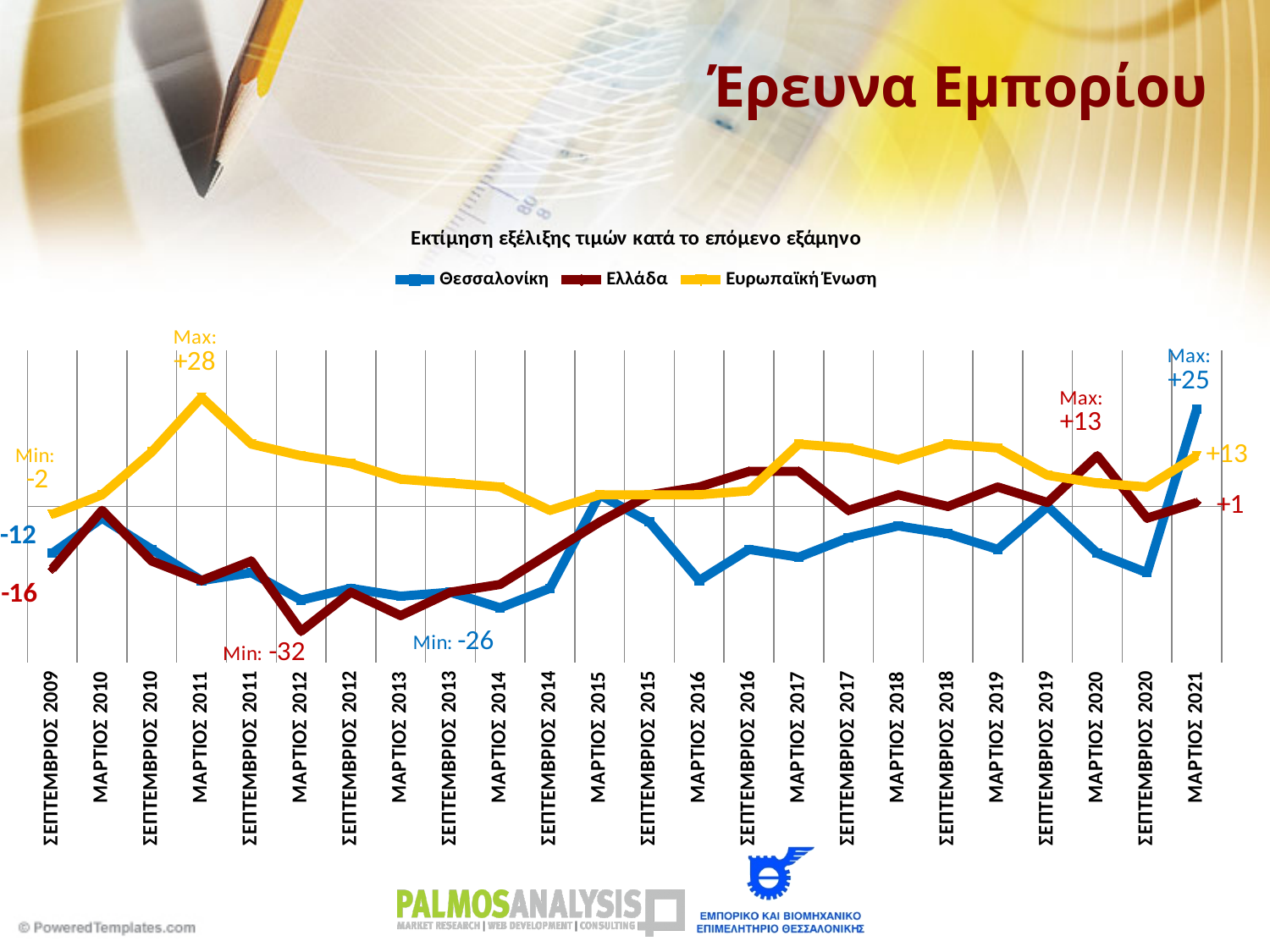
What is the maximum value labelled for the Ευρωπαϊκή Ένωση series? +28 What is the value for Θεσσαλονίκη in ΜΑΡΤΙΟΣ 2021? +25 What is the difference between the Θεσσαλονίκη and Ευρωπαϊκή Ένωση values in ΜΑΡΤΙΟΣ 2021? 12 In ΜΑΡΤΙΟΣ 2021, which series has the higher value, Θεσσαλονίκη or Ελλάδα? Θεσσαλονίκη What is the minimum value labelled for the Θεσσαλονίκη series? -26 What is the minimum value labelled for the Ελλάδα series? -32 What is the value for Ελλάδα in ΣΕΠΤΕΜΒΡΙΟΣ 2009? -16 How many time points are shown on the x axis? 24 What type of chart is shown on the slide? line chart How many series does the legend list? 3 What is the title of the chart? Εκτίμηση εξέλιξης τιμών κατά το επόμενο εξάμηνο What is the value for Ευρωπαϊκή Ένωση in ΜΑΡΤΙΟΣ 2021? +13